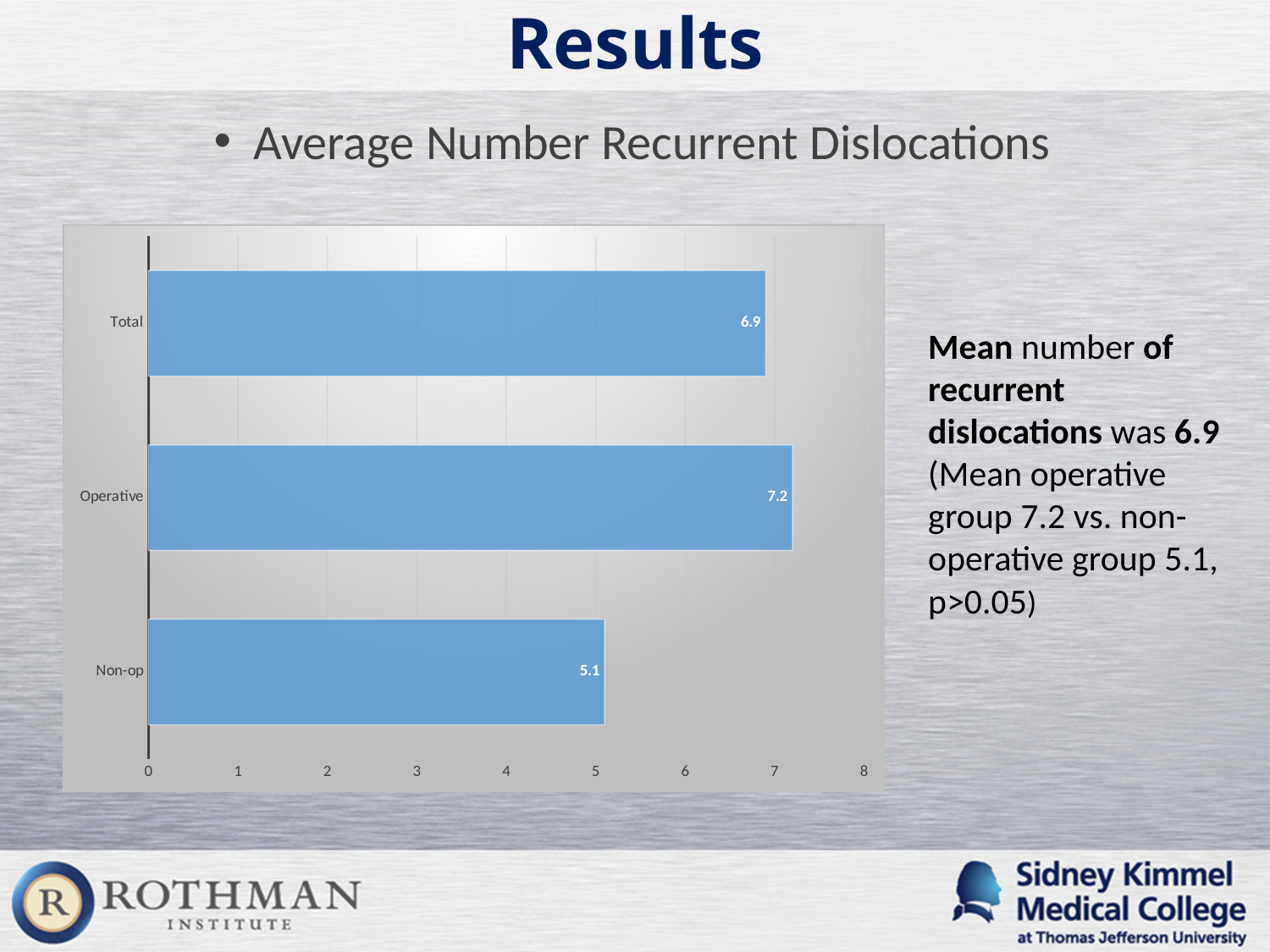
Which category has the lowest value? Non-op What is the difference between the Operative and Total values? 0.3 What is the maximum value shown on the horizontal axis? 8 Is the value for Non-op greater or less than 6? less What is the value for Non-op? 5.1 Which category has the highest value? Operative How many categories are shown in the chart? 3 What is the value for Operative? 7.2 What kind of chart is shown on the slide? bar chart What is the difference between the Operative and Non-op values? 2.1 What is the value for Total? 6.9 Which is larger, the value for Total or the value for Non-op? Total